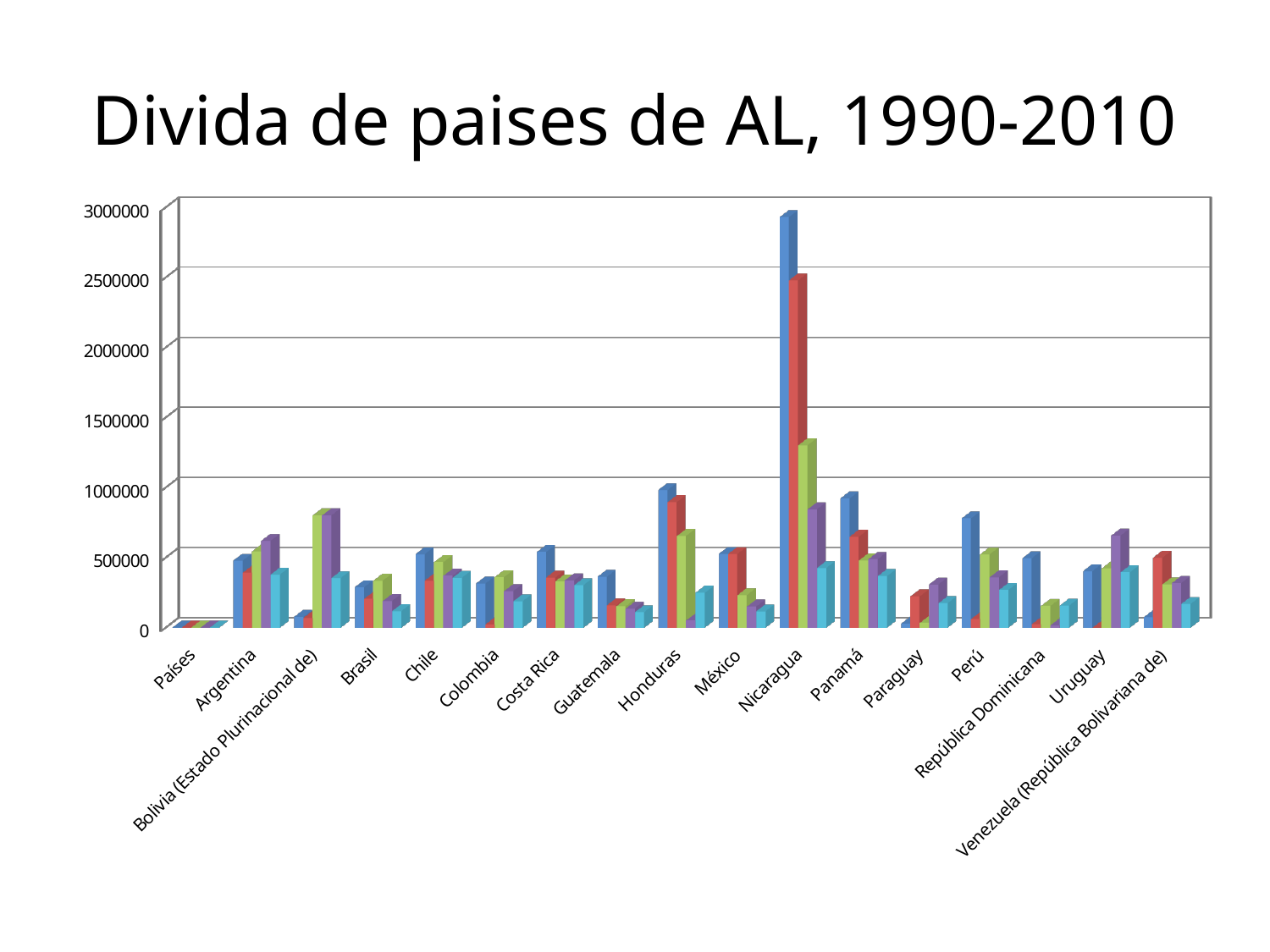
How many categories are shown along the x axis of the chart? 17 Which has the taller blue bar, Nicaragua or Honduras? Nicaragua Is the blue bar for Brasil greater or less than 500000? less Is the green bar for Bolivia (Estado Plurinacional de) greater or less than 500000? greater What kind of chart is shown on the slide? bar chart Which country has the tallest bar in the chart? Nicaragua Is the tallest blue bar for Nicaragua greater or less than 2500000? greater What is the title of the chart? Divida de paises de AL, 1990-2010 Which has the taller blue bar, Perú or Paraguay? Perú